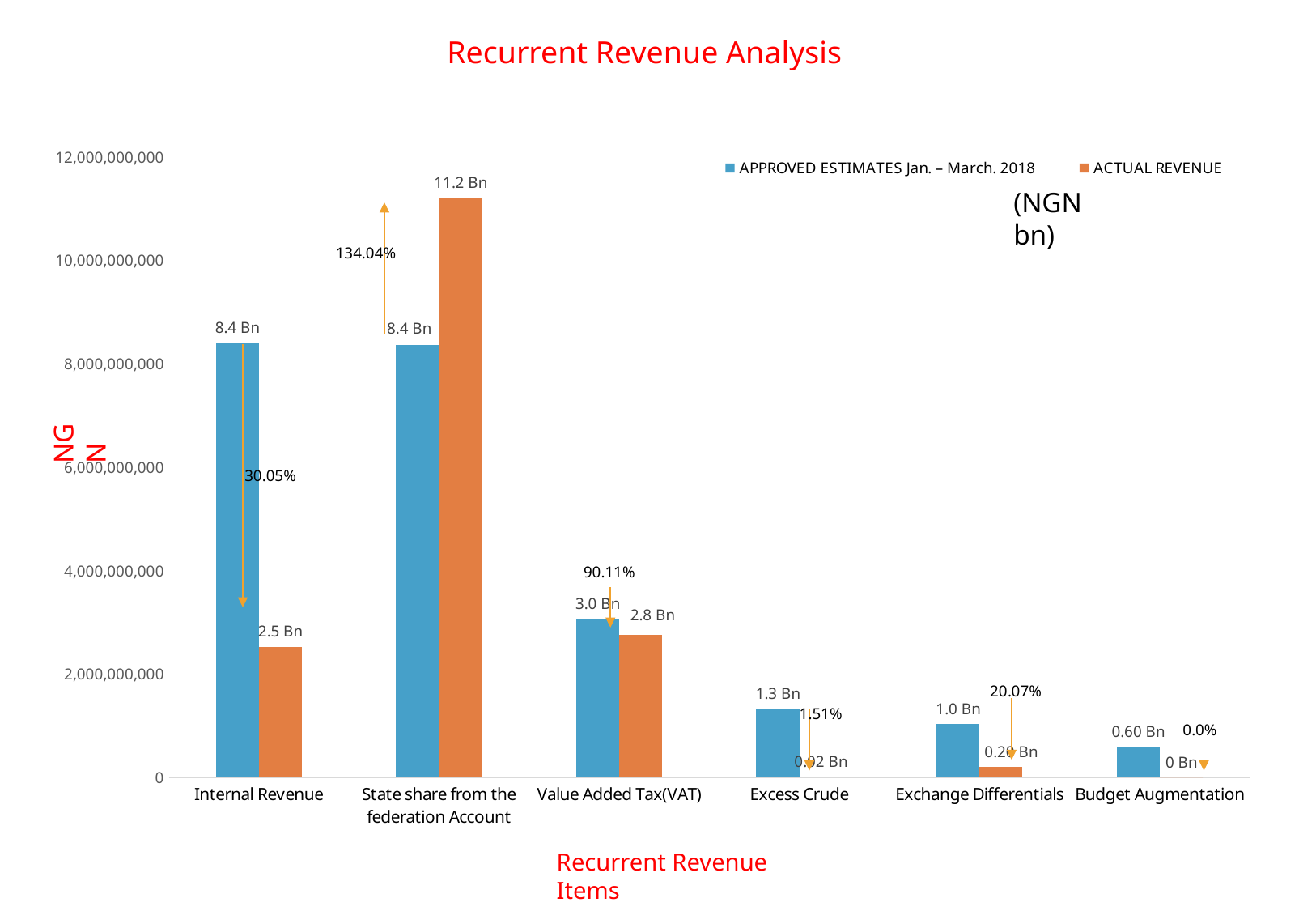
Which is larger for Value Added Tax(VAT): the APPROVED ESTIMATES or the ACTUAL REVENUE? APPROVED ESTIMATES What is the ACTUAL REVENUE value for State share from the federation Account? 11.2 Bn How many series does the legend list? 2 What is the APPROVED ESTIMATES Jan. – March. 2018 value for Budget Augmentation? 0.60 Bn How many categories are shown on the x axis? 6 Is the APPROVED ESTIMATES value for Internal Revenue greater or less than 8,000,000,000? greater What is the difference between the ACTUAL REVENUE and the APPROVED ESTIMATES for Internal Revenue? 5.9 Bn What is the ACTUAL REVENUE value for Excess Crude? 0.02 Bn What is the APPROVED ESTIMATES Jan. – March. 2018 value for Internal Revenue? 8.4 Bn Which category has the lowest ACTUAL REVENUE? Budget Augmentation What type of chart is shown on the slide? bar chart Which category has the highest ACTUAL REVENUE? State share from the federation Account